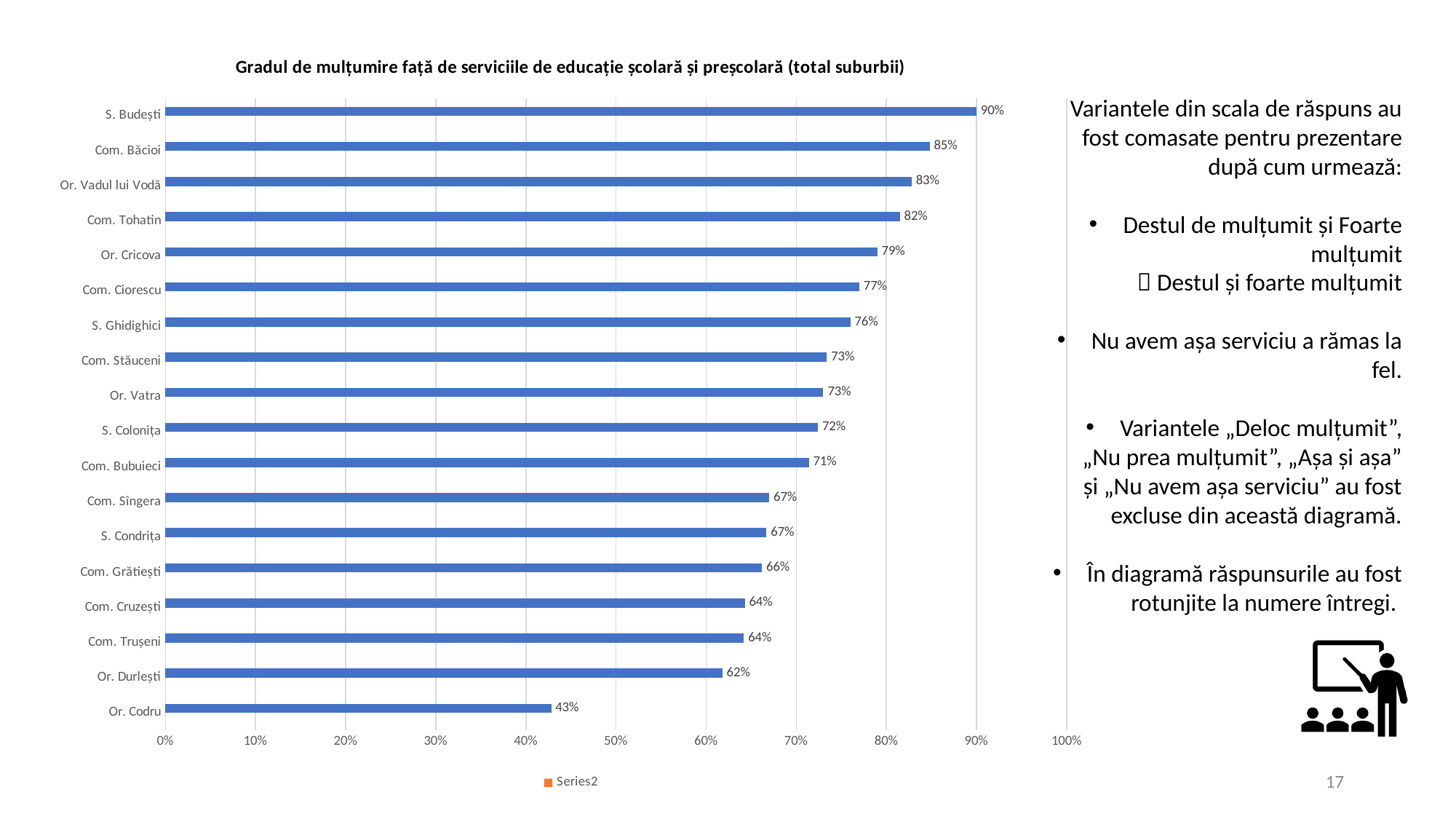
What is the value for Or. Cricova? 79% Which category has the highest value? S. Budești What is the difference between the values for S. Budești and Or. Codru? 47% How many categories are shown in the chart? 18 What is the title of the chart? Gradul de mulțumire față de serviciile de educație școlară și preșcolară (total suburbii) What is the value for Com. Grătiești? 66% Which is larger, the value for Com. Tohatin or the value for Com. Ciorescu? Com. Tohatin Which category has the lowest value? Or. Codru What is the difference between the values for Com. Băcioi and Or. Durlești? 23% What kind of chart is shown on the slide? Bar chart What is the value for S. Budești? 90% How many series does the legend list? 1